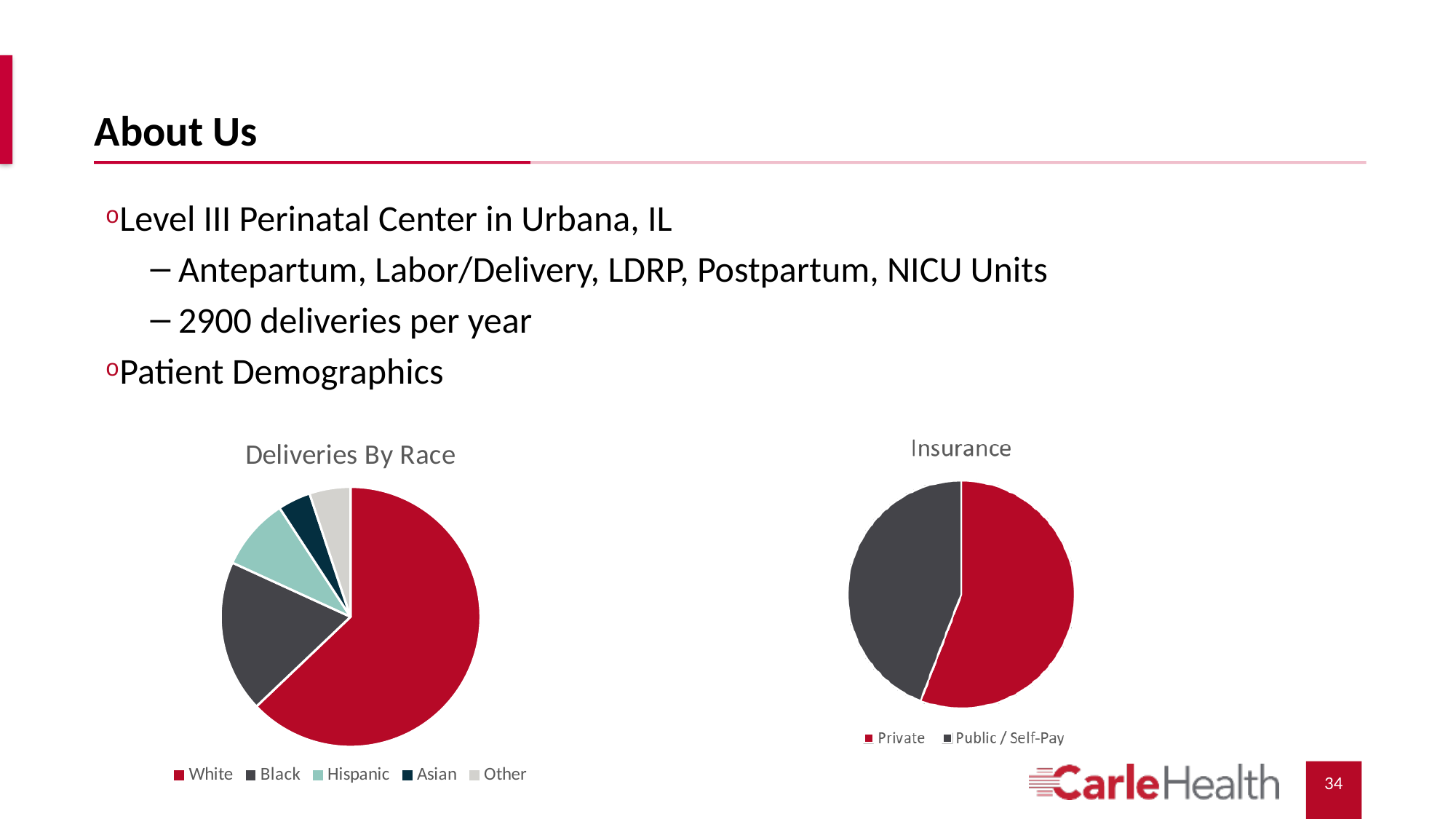
In the "Insurance" chart, how many categories does the legend list? 2 In the "Deliveries By Race" chart, which category has the largest slice? White What kind of chart is the "Insurance" chart? pie chart In the "Insurance" chart, which slice is larger, Private or Public / Self-Pay? Private In the "Deliveries By Race" chart, is the White slice greater or less than half of the pie? greater In the "Deliveries By Race" chart, which slice is larger, Black or Hispanic? Black In the "Deliveries By Race" chart, which category is the second largest slice? Black What are the two legend entries of the "Insurance" chart? Private and Public / Self-Pay In the "Deliveries By Race" chart, how many categories does the legend list? 5 What kind of chart is the "Deliveries By Race" chart? pie chart In the "Deliveries By Race" chart, which slice is larger, White or Black? White